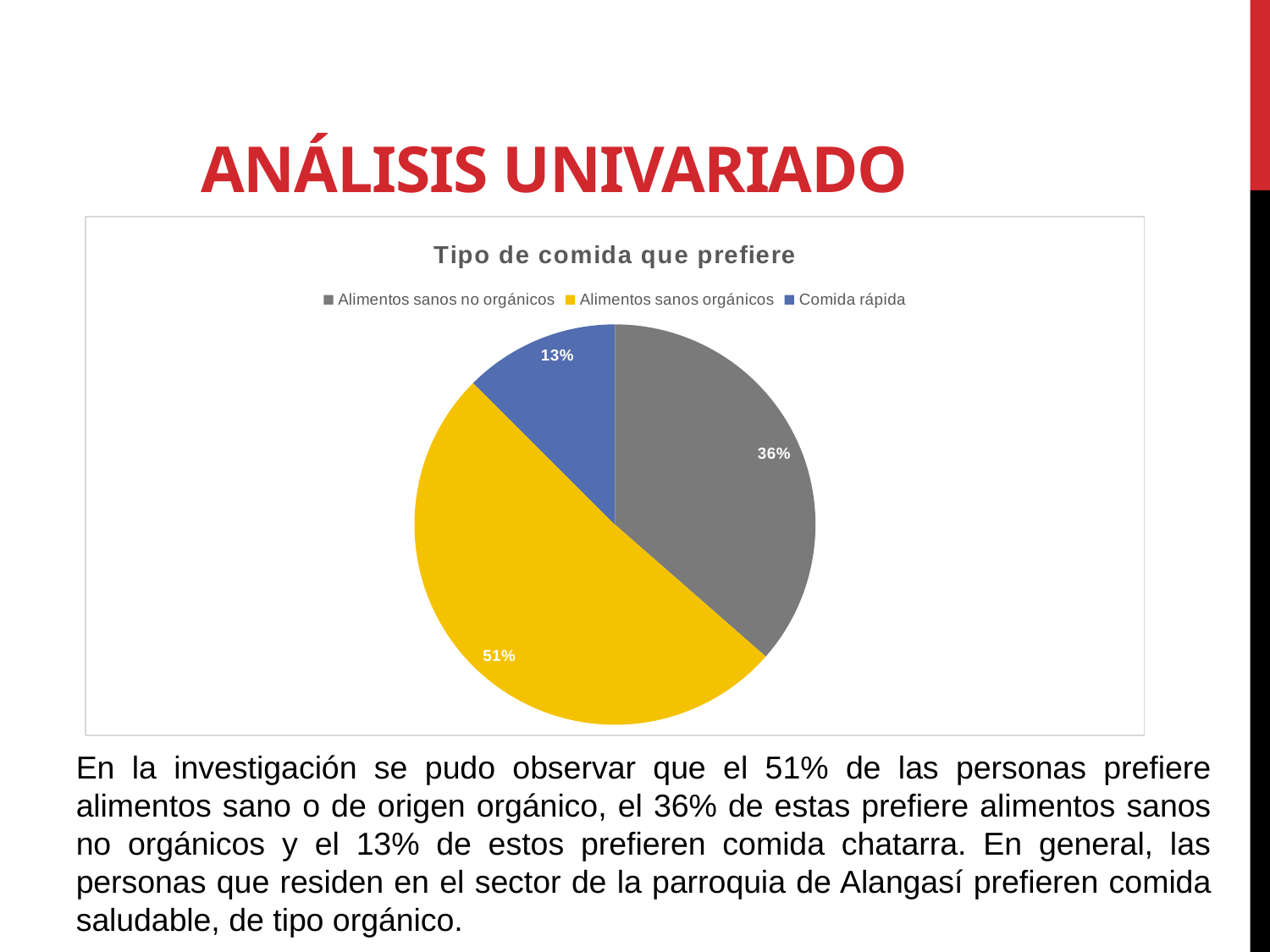
What share of the pie is Comida rápida? 13% What is the title of the chart? Tipo de comida que prefiere What is the difference between the shares for Alimentos sanos no orgánicos and Comida rápida? 23% What is the difference between the shares for Alimentos sanos orgánicos and Alimentos sanos no orgánicos? 15% How many categories does the pie chart show? 3 What share of the pie is Alimentos sanos no orgánicos? 36% Which category has the largest slice of the pie? Alimentos sanos orgánicos Which category has the smallest slice of the pie? Comida rápida What kind of chart is shown on the slide? pie chart What share of the pie is Alimentos sanos orgánicos? 51% Which is larger, the share for Alimentos sanos no orgánicos or the share for Comida rápida? Alimentos sanos no orgánicos What colour is the slice for Comida rápida? blue